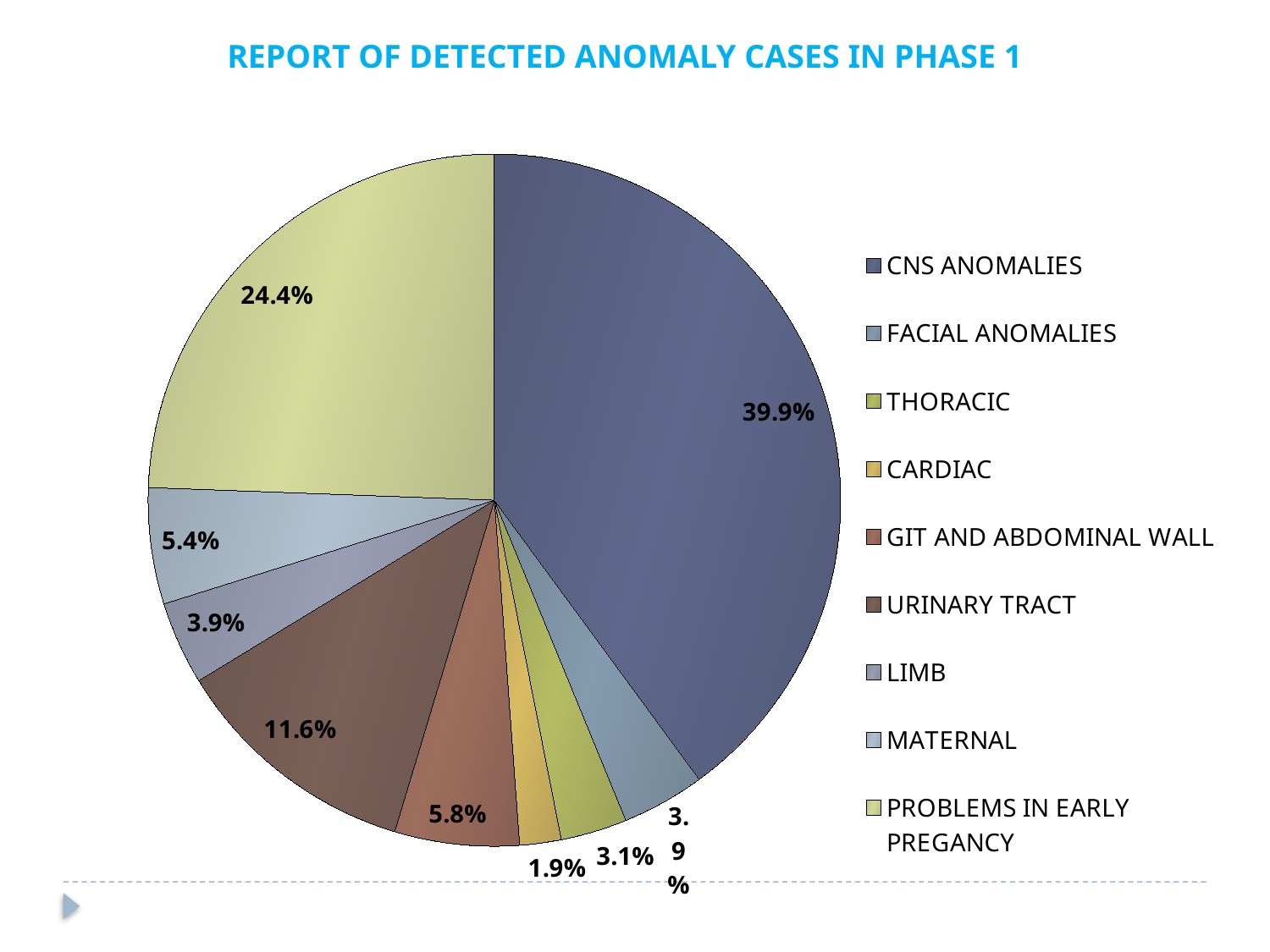
What percentage of cases are PROBLEMS IN EARLY PREGANCY? 24.4% What is the title of the chart? REPORT OF DETECTED ANOMALY CASES IN PHASE 1 What kind of chart is shown on the slide? pie chart Which category has the largest share of the pie? CNS ANOMALIES What percentage of cases are MATERNAL? 5.4% What percentage of cases are URINARY TRACT anomalies? 11.6% What percentage of cases are CARDIAC anomalies? 1.9% Which category has the smallest share of the pie? CARDIAC What percentage of cases are GIT AND ABDOMINAL WALL anomalies? 5.8% How many categories does the legend list? 9 What percentage of cases are CNS ANOMALIES? 39.9% What is the difference in percentage points between CNS ANOMALIES and PROBLEMS IN EARLY PREGANCY? 15.5